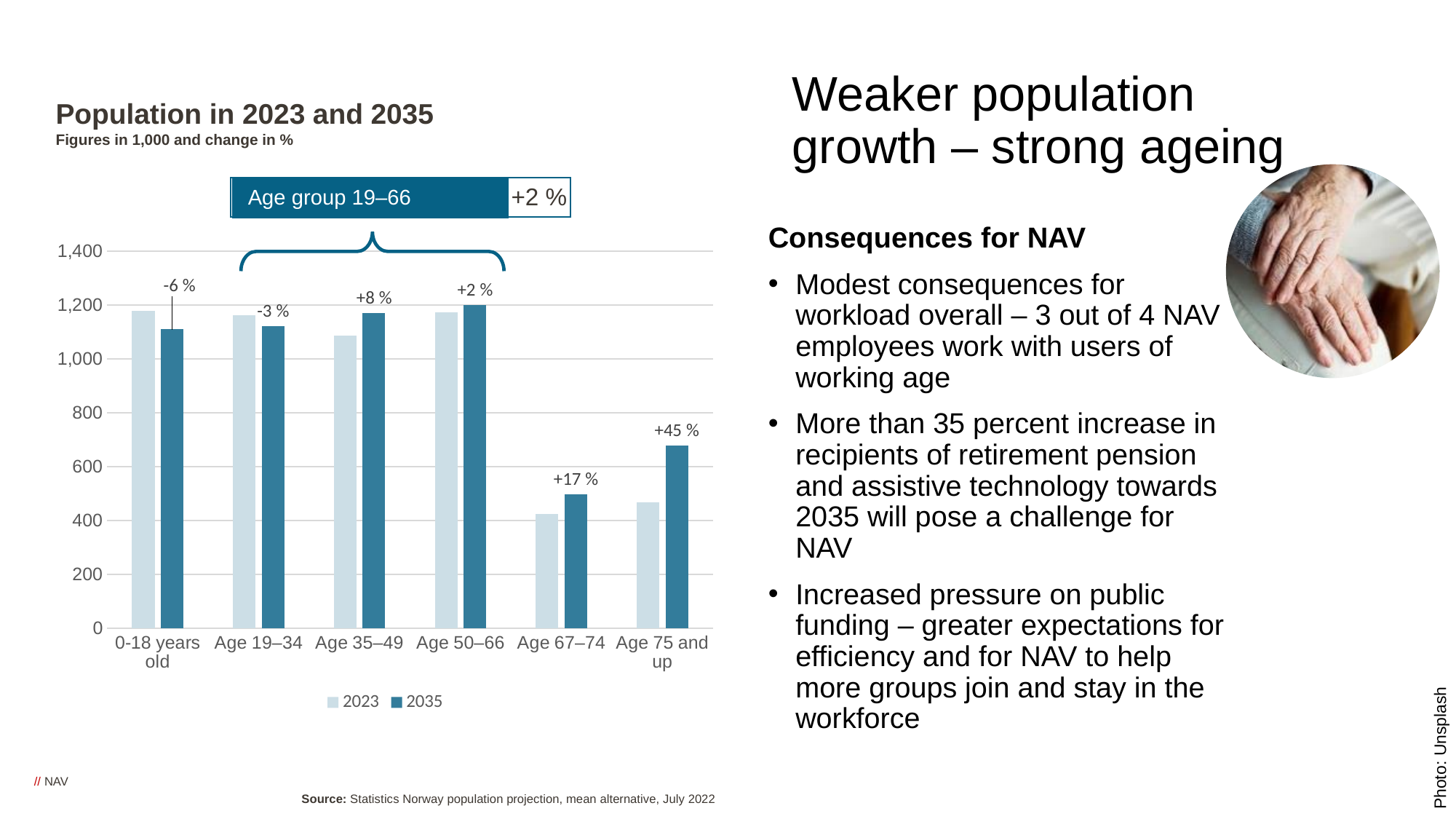
Which is larger for Age 75 and up, the 2023 value or the 2035 value? 2035 How many age group categories are shown on the x axis of the chart? 6 What kind of chart is shown on the slide? bar chart What percentage change is labelled for the Age 75 and up group? +45 % What percentage change is shown for the combined Age group 19–66? +2 % What percentage change is labelled for the 0-18 years old group? -6 % Which age group has the lowest labelled percentage change? 0-18 years old What percentage change is labelled for the Age 35–49 group? +8 % How many series does the chart legend list? 2 Is the 2035 value for Age 67–74 greater or less than 600? less Which age group has the largest labelled percentage change? Age 75 and up Is the 2023 value for Age 50–66 greater or less than 1,000? greater